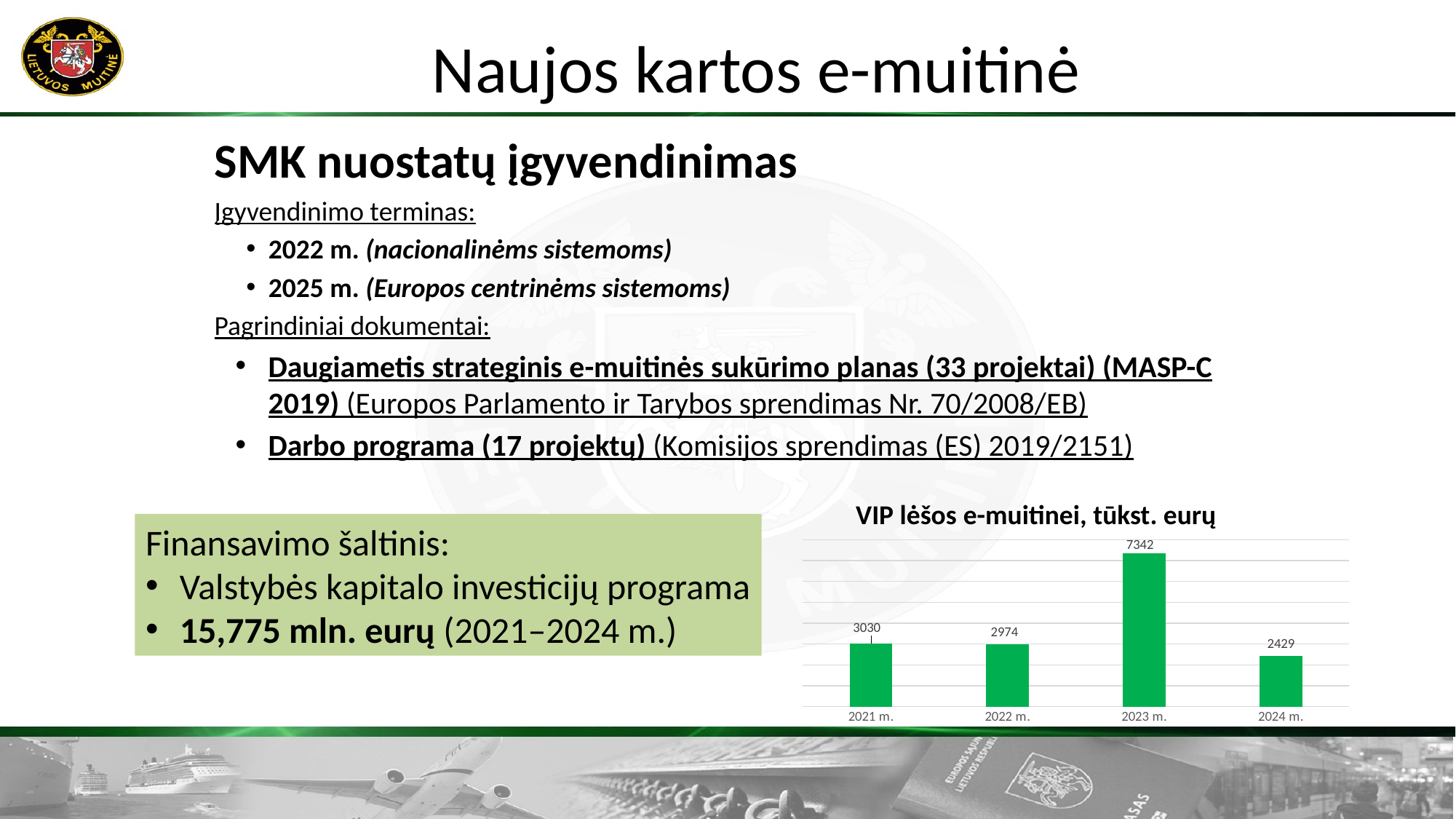
Which year has the lowest value in the chart? 2024 m. Which is larger, the value for 2021 m. or the value for 2024 m.? 2021 m. What is the difference between the values for 2021 m. and 2022 m.? 56 Which year has the highest value in the chart? 2023 m. What is the value for 2023 m. in the chart? 7342 What is the value for 2022 m. in the chart? 2974 What is the value for 2024 m. in the chart? 2429 What kind of chart is shown on the slide? Bar chart What is the value for 2021 m. in the chart? 3030 What is the difference between the values for 2023 m. and 2024 m.? 4913 How many years are shown in the chart? 4 What is the title of the chart? VIP lėšos e-muitinei, tūkst. eurų